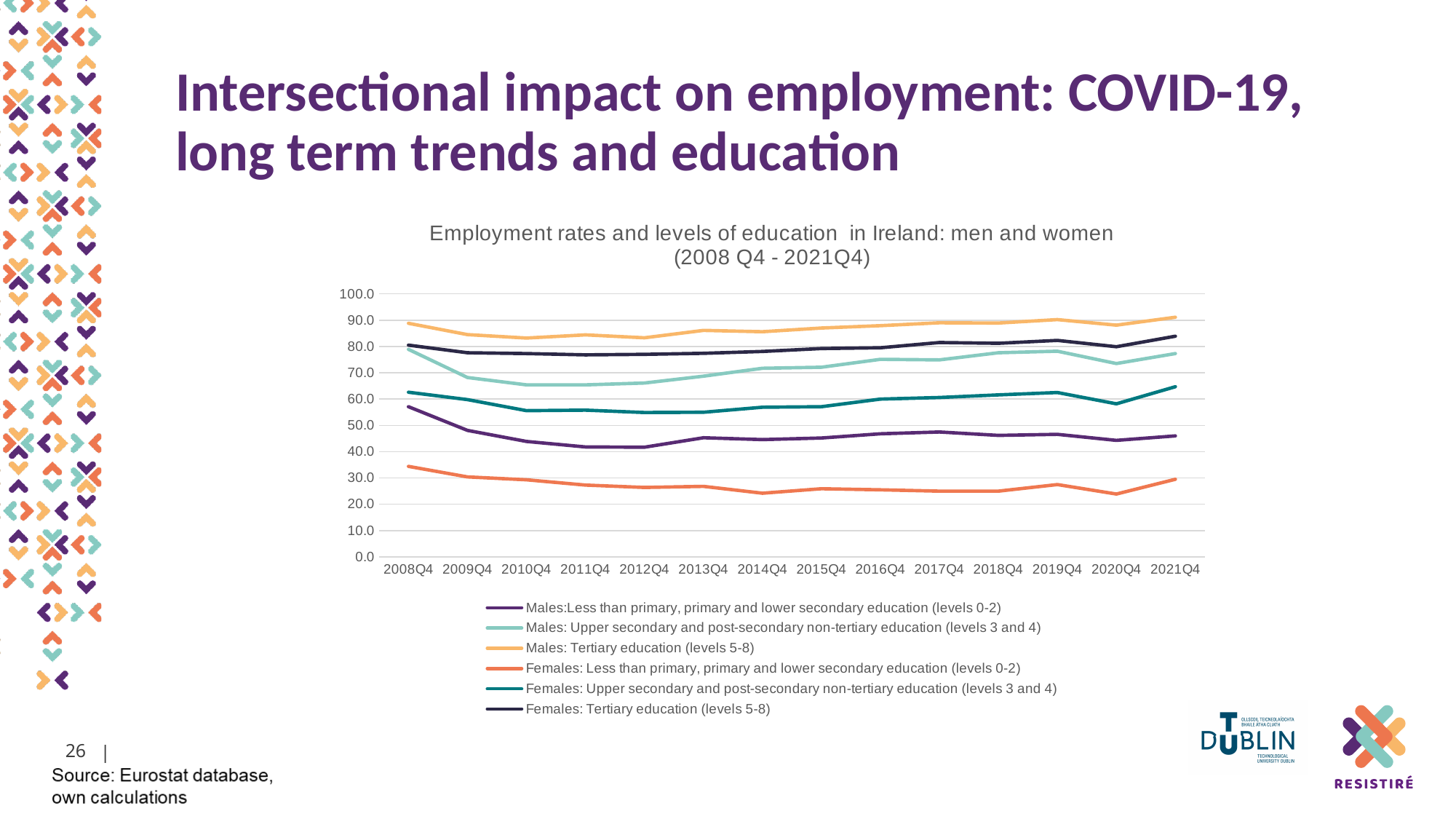
Is the value for Males: Less than primary, primary and lower secondary education (levels 0-2) at 2008Q4 greater or less than 50? greater Is the value for Females: Less than primary, primary and lower secondary education (levels 0-2) at 2014Q4 greater or less than 30? less Does the value for Females: Tertiary education (levels 5-8) rise or fall from 2012Q4 to 2019Q4? rise Is the value for Males: Tertiary education (levels 5-8) at 2021Q4 greater or less than 80? greater Which series has the lowest value at 2021Q4? Females: Less than primary, primary and lower secondary education (levels 0-2) Which series has the highest value at 2008Q4? Males: Tertiary education (levels 5-8) What kind of chart is shown on the slide? line chart At 2021Q4, which is larger: the value for Males: Less than primary, primary and lower secondary education (levels 0-2) or the value for Females: Upper secondary and post-secondary non-tertiary education (levels 3 and 4)? Females: Upper secondary and post-secondary non-tertiary education (levels 3 and 4) How many series does the legend list? 6 Does the value for Males: Less than primary, primary and lower secondary education (levels 0-2) rise or fall from 2008Q4 to 2012Q4? fall What is the title of the chart? Employment rates and levels of education in Ireland: men and women (2008 Q4 - 2021Q4) How many time points are shown on the x axis? 14